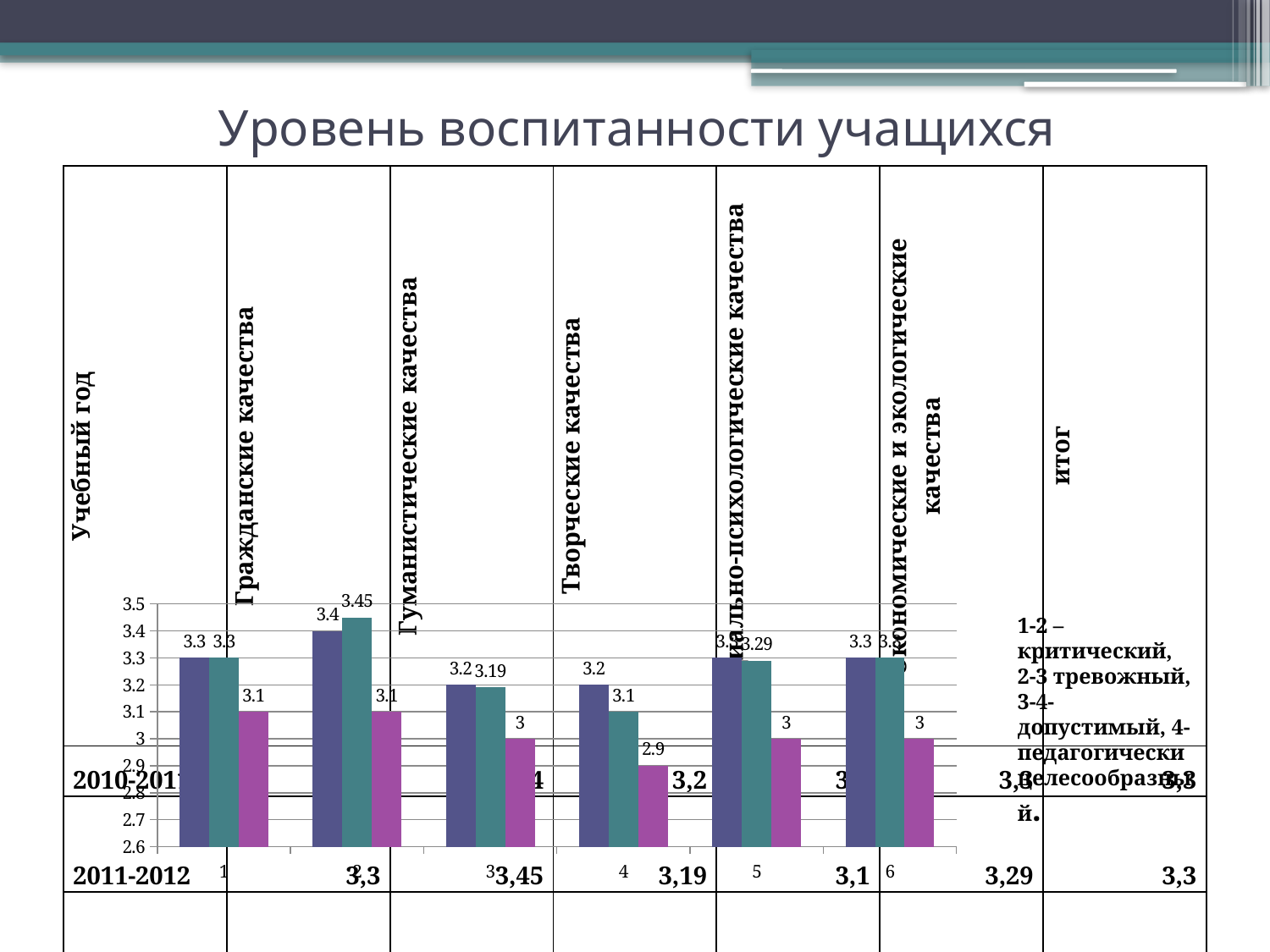
What is the difference between the dark blue bar (3.2) and the magenta bar (2.9) for category 4? 0.3 Is the value of the magenta bar for category 4 greater or less than 3? less How many categories are plotted along the x axis of the chart? 6 What kind of chart is shown on the slide? bar chart Which category has the highest teal bar? 2 What is the value of the teal bar for category 5? 3.29 Which category has the lowest magenta bar? 4 What is the value of the dark blue bar for category 2? 3.4 What is the value of the magenta bar for category 4? 2.9 What is the title of the slide containing the chart? Уровень воспитанности учащихся Which is larger: the teal bar for category 2 or the teal bar for category 3? teal bar for category 2 What is the value of the teal bar for category 2? 3.45